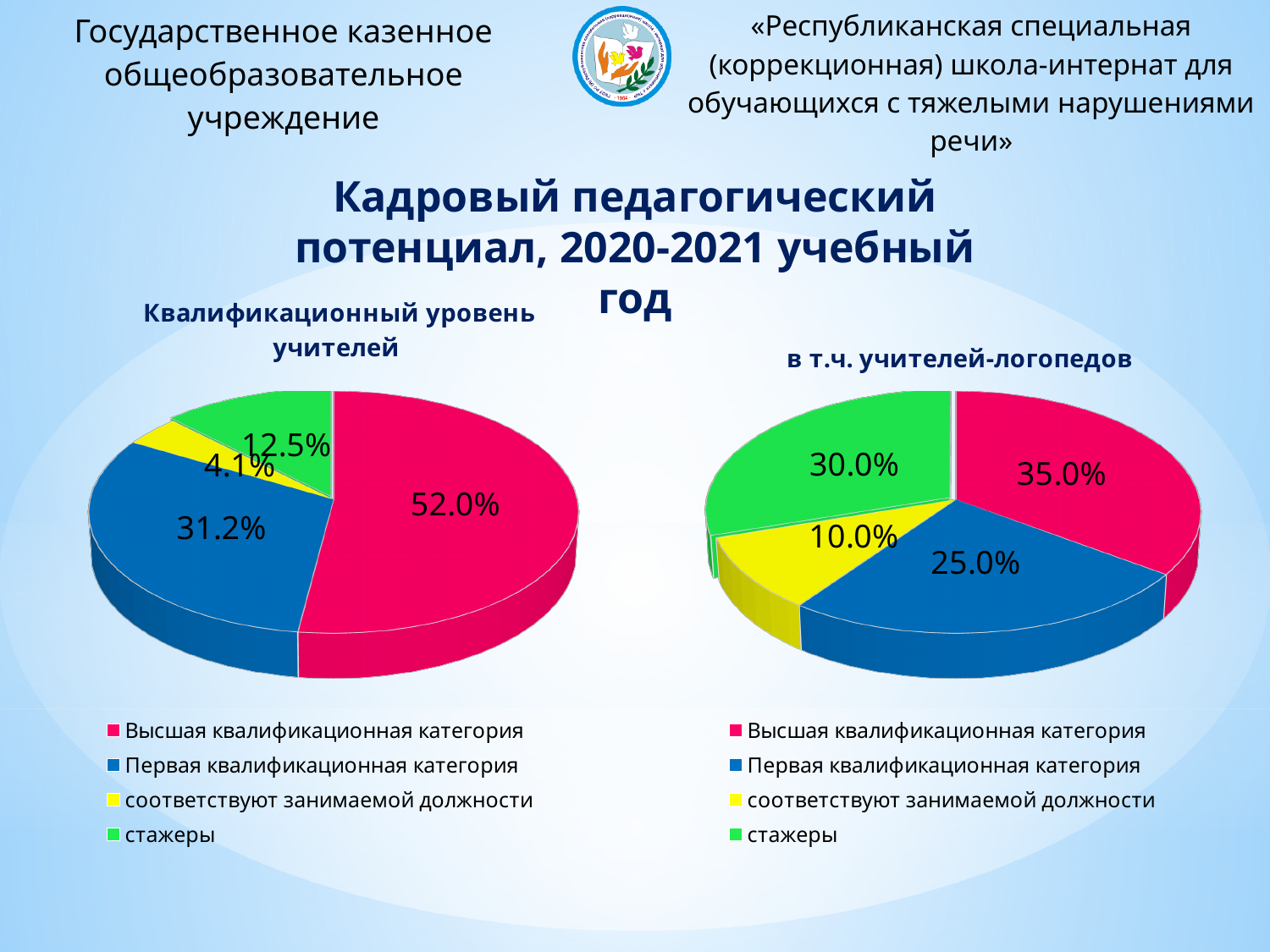
On the chart 'в т.ч. учителей-логопедов', what share is shown for 'стажеры'? 30.0% How many categories does the legend of the chart 'Квалификационный уровень учителей' list? 4 On the chart 'Квалификационный уровень учителей', which category has the smallest slice? соответствуют занимаемой должности What type of chart is 'в т.ч. учителей-логопедов'? Pie chart On the chart 'в т.ч. учителей-логопедов', what share is shown for 'соответствуют занимаемой должности'? 10.0% On the chart 'в т.ч. учителей-логопедов', what is the difference between the shares for 'Высшая квалификационная категория' and 'Первая квалификационная категория'? 10.0% On the chart 'Квалификационный уровень учителей', what is the difference between the shares for 'Высшая квалификационная категория' and 'Первая квалификационная категория'? 20.8% On the chart 'в т.ч. учителей-логопедов', which category has the largest slice? Высшая квалификационная категория On the chart 'Квалификационный уровень учителей', what share is shown for 'Первая квалификационная категория'? 31.2% On the chart 'Квалификационный уровень учителей', what share is shown for 'Высшая квалификационная категория'? 52.0% On the chart 'Квалификационный уровень учителей', what share is shown for 'стажеры'? 12.5% On the chart 'в т.ч. учителей-логопедов', which is larger: the share for 'Первая квалификационная категория' or the share for 'стажеры'? стажеры